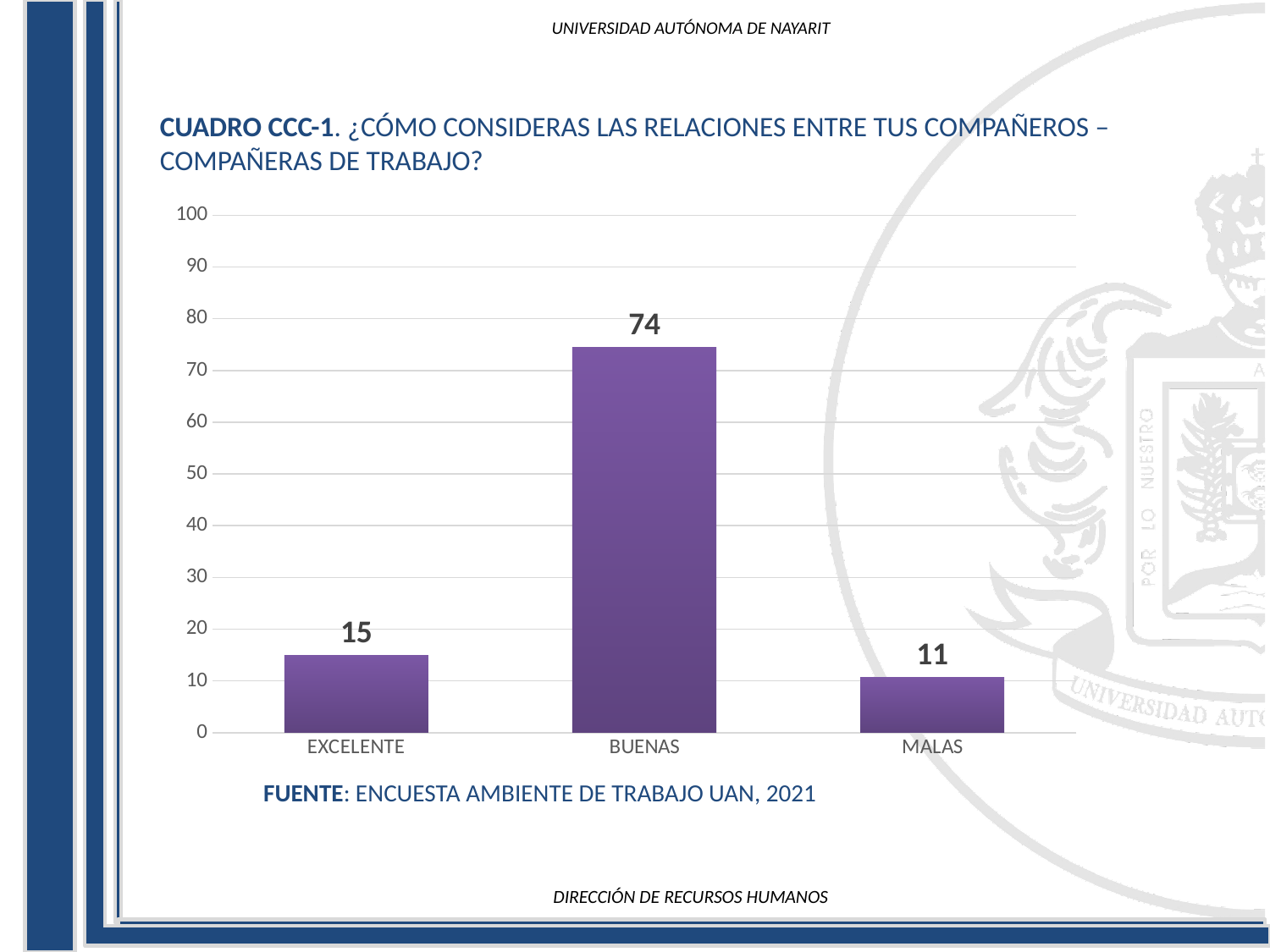
What is the value for EXCELENTE? 15 What is the difference between the values for EXCELENTE and MALAS? 4 Is the value for BUENAS greater or less than 70? greater What source is cited below the chart? ENCUESTA AMBIENTE DE TRABAJO UAN, 2021 What is the value for BUENAS? 74 What kind of chart is shown on the slide? bar chart Which is larger, the value for EXCELENTE or the value for MALAS? EXCELENTE Which category has the highest value? BUENAS How many categories are shown on the x axis? 3 Which category has the lowest value? MALAS What is the value for MALAS? 11 What is the difference between the values for BUENAS and EXCELENTE? 59